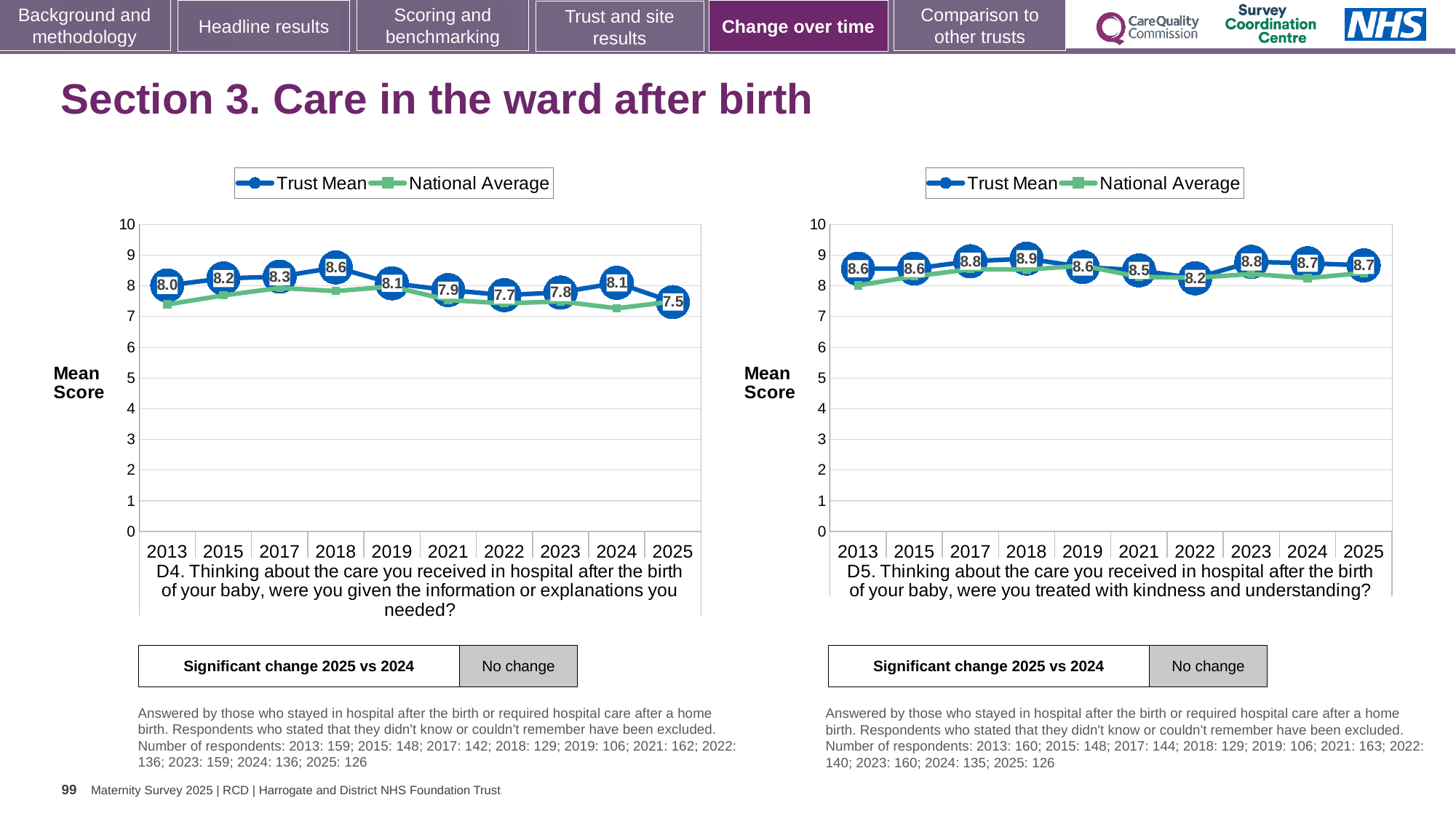
In the D4 chart (left), which year has the lowest Trust Mean? 2025 In the D5 chart (right), which year has the highest Trust Mean? 2018 In the D5 chart (right), what is the Trust Mean for 2022? 8.2 In the D4 chart (left), does the Trust Mean rise or fall from 2024 to 2025? Fall What does the 'Significant change 2025 vs 2024' box under the D5 chart (right) say? No change In the D4 chart (left), what is the difference between the Trust Mean in 2018 and in 2025? 1.1 How many series does the legend of the D4 chart (left) list? 2 How many years are plotted on the x axis of the D5 chart (right)? 10 In the D4 chart (left), what is the Trust Mean for 2018? 8.6 In the D4 chart (left), is the National Average for 2013 greater or less than 8? less What kind of chart is the D4 chart (left)? Line chart In the D5 chart (right), is the Trust Mean for 2013 or for 2022 larger? 2013